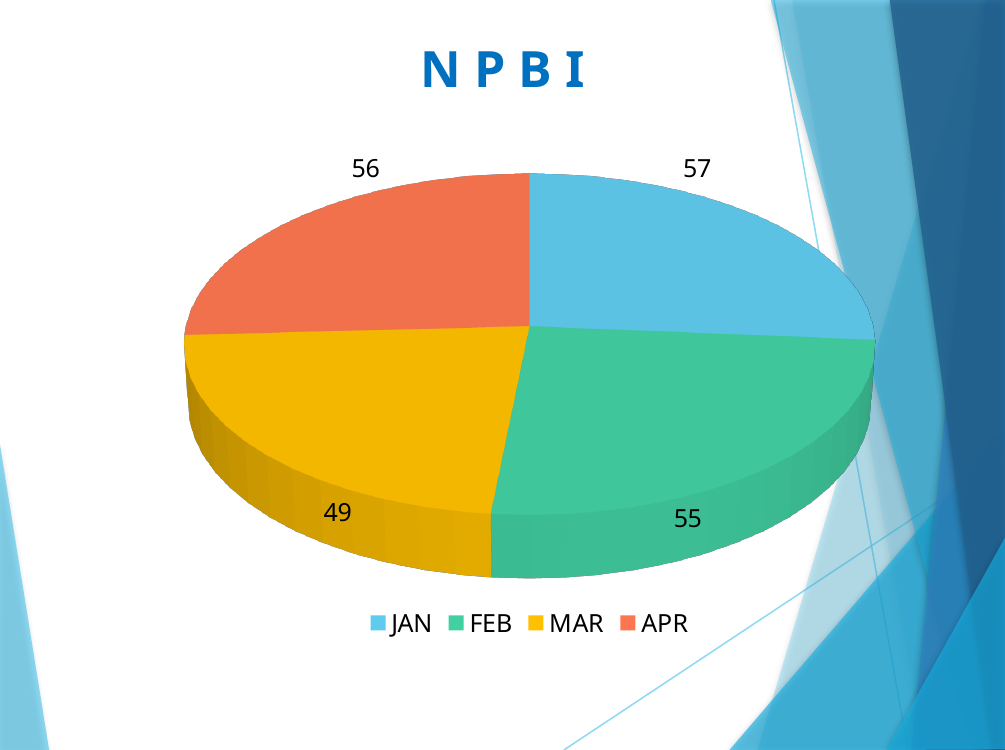
What is the value for FEB? 55 Which month has the highest value? JAN How many slices does the pie chart have? 4 Which is larger, the value for FEB or the value for APR? APR What is the total of all four slices? 217 What is the value for MAR? 49 What kind of chart is shown on the slide? Pie chart What is the value for JAN? 57 What is the difference between the values for JAN and MAR? 8 What is the title of the chart? NPBI What is the value for APR? 56 Which month has the lowest value? MAR